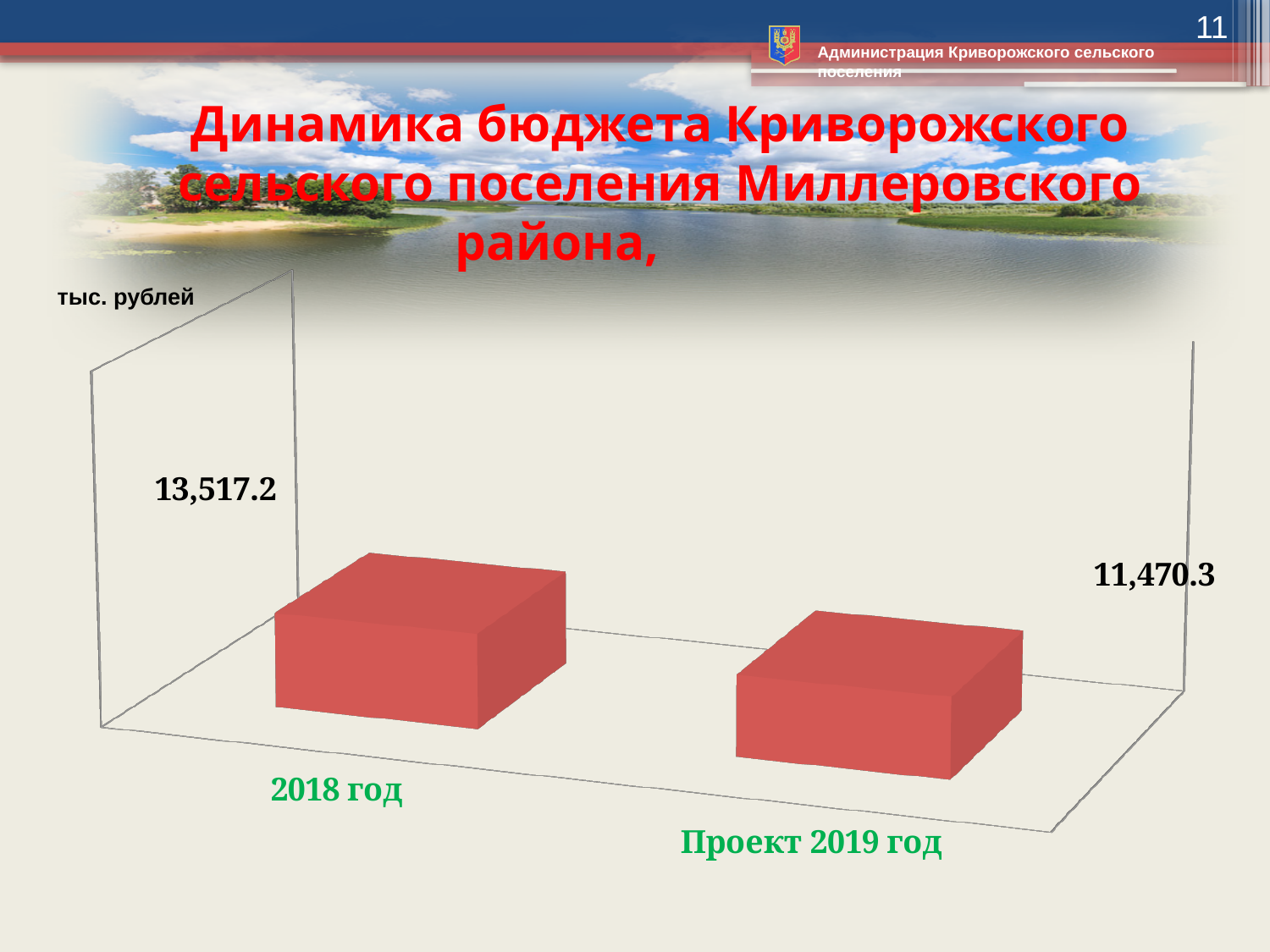
Which is larger, the value for 2018 год or the value for Проект 2019 год? 2018 год What is the difference between the values for 2018 год and Проект 2019 год? 2,046.9 What colour are the bars in the chart? Red How many categories are shown in the chart? 2 What is the value for Проект 2019 год? 11,470.3 Which category has the highest value? 2018 год What unit of measurement is indicated for the chart values? тыс. рублей What kind of chart is shown on the slide? Bar chart Which category has the lowest value? Проект 2019 год Do the values rise or fall from 2018 год to Проект 2019 год? Fall What is the value for 2018 год? 13,517.2